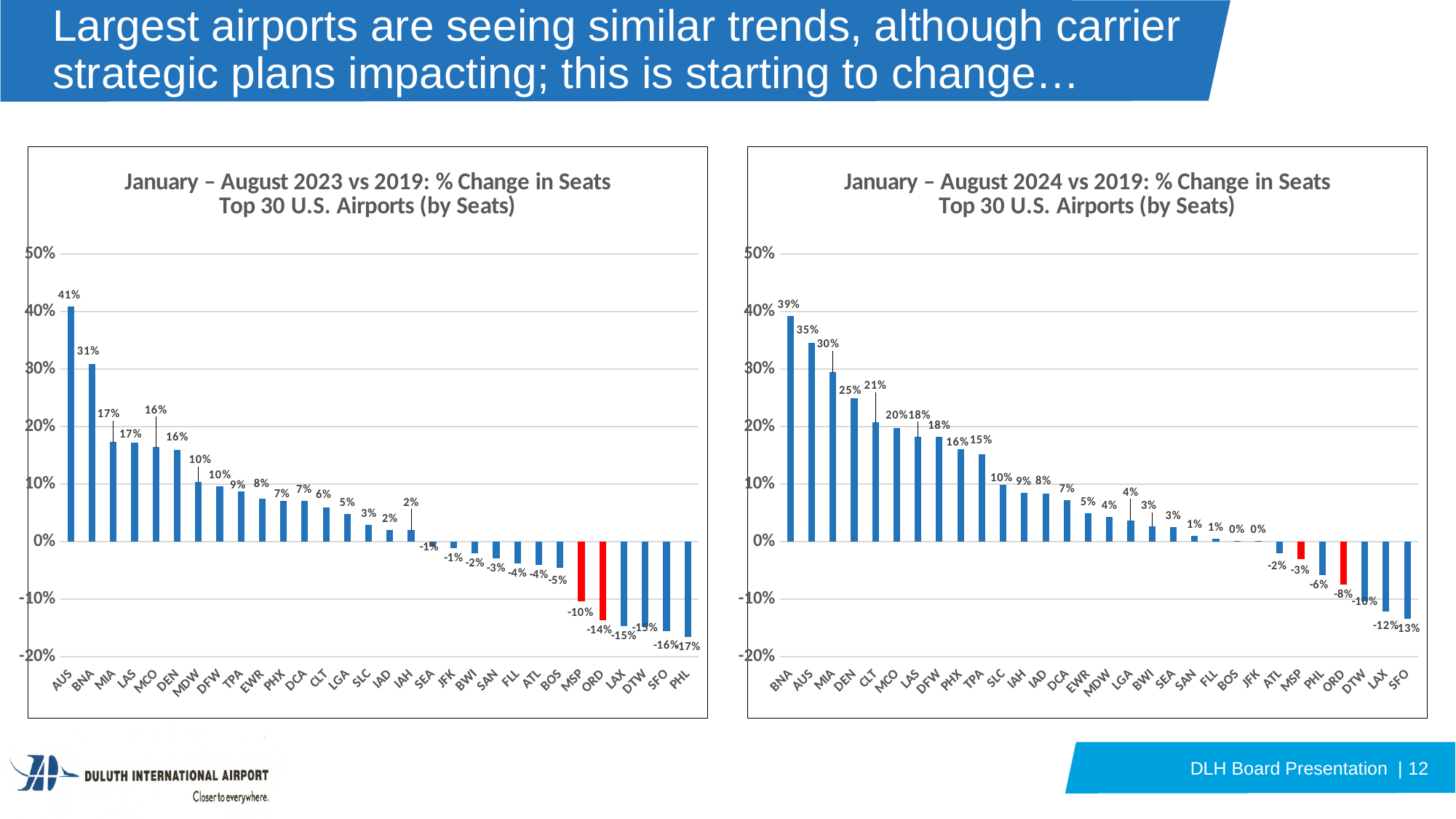
In the 2023 vs 2019 chart on the left, what is the % change in seats for AUS? 41% In the 2024 vs 2019 chart on the right, what is the % change in seats for MSP? -3% In the 2023 vs 2019 chart on the left, do the values rise or fall from left to right along the x axis? Fall Which two airports are highlighted with red bars in both charts? MSP and ORD In the 2023 vs 2019 chart on the left, which airport has the lowest % change in seats? PHL How many airports are shown in the 2023 vs 2019 chart on the left? 30 In the 2024 vs 2019 chart on the right, what is the % change in seats for SFO? -13% In the 2024 vs 2019 chart on the right, is the value for MIA greater or less than 20%? greater In the 2024 vs 2019 chart on the right, what is the difference between the values for BNA and AUS? 4% What type of chart is the 2024 vs 2019 chart on the right? Bar chart In the 2024 vs 2019 chart on the right, which airport has the highest % change in seats? BNA In the 2023 vs 2019 chart on the left, which has a larger % change in seats, MSP or ORD? MSP